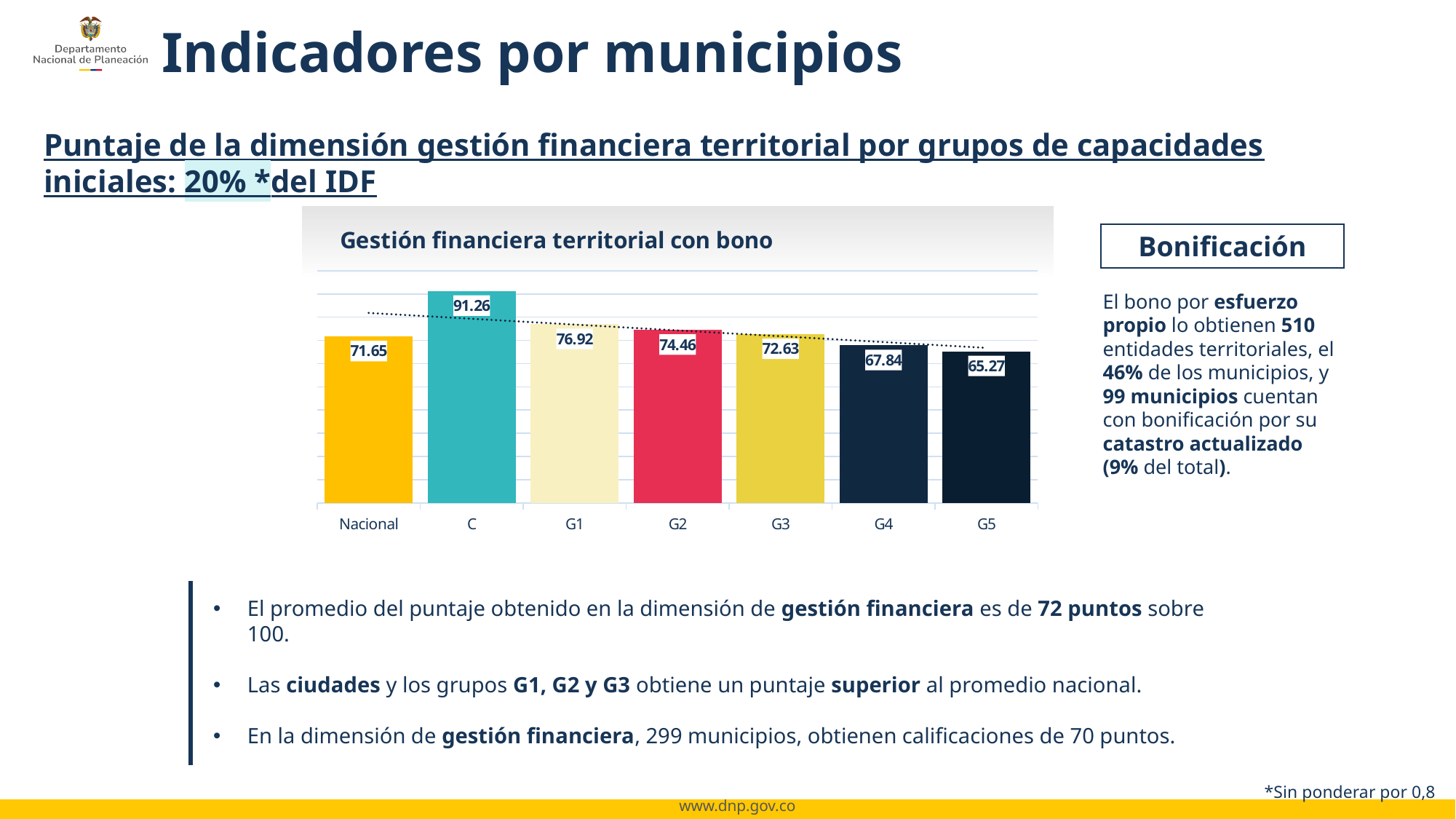
Which category has the highest value in the chart? C Which is larger, the value for G4 or the value for G5? G4 What is the difference between the values for G1 and G2? 2.46 What is the value for G5 in the chart? 65.27 How many categories are shown on the x axis of the chart? 7 What is the title of the chart? Gestión financiera territorial con bono Which category has the lowest value in the chart? G5 What kind of chart is shown on the slide? Bar chart What is the difference between the values for C and Nacional? 19.61 What is the value for Nacional in the chart? 71.65 What is the value for G3 in the chart? 72.63 What is the value for C in the chart? 91.26